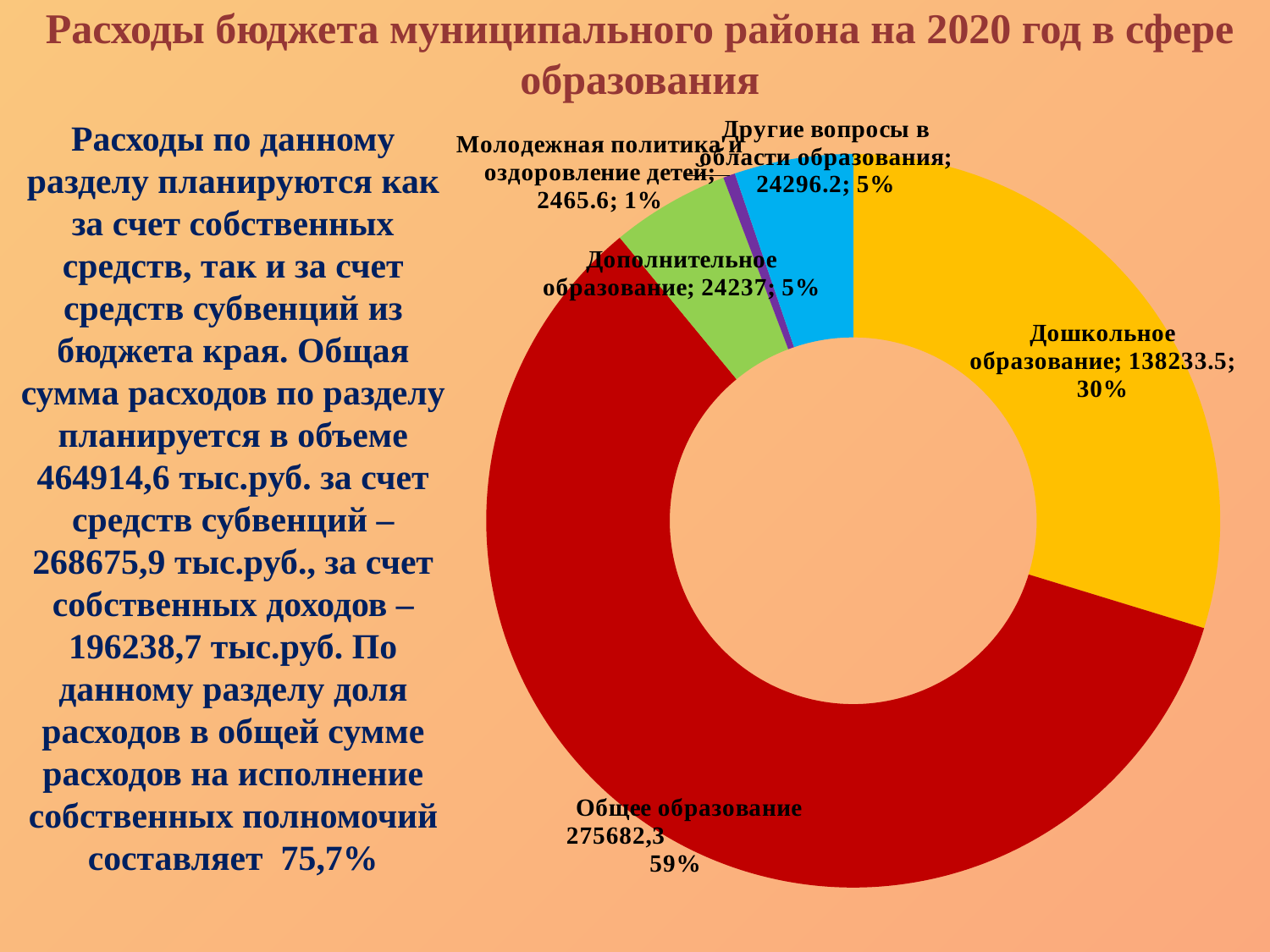
Which is larger: Дошкольное образование or Общее образование? Общее образование What colour is the slice for Дошкольное образование? Yellow Which category has the smallest share of the chart? Молодежная политика и оздоровление детей What is the value for Дополнительное образование? 24237 What is the value for Молодежная политика и оздоровление детей? 2465.6 What share of the chart does Другие вопросы в области образования represent? 5% What share of the chart does Общее образование represent? 59% What is the difference between the values for Другие вопросы в области образования and Дополнительное образование? 59.2 What type of chart is shown on the slide? Doughnut (pie) chart What is the value for Дошкольное образование? 138233.5 Which category has the largest share of the chart? Общее образование How many categories (slices) does the chart show? 5